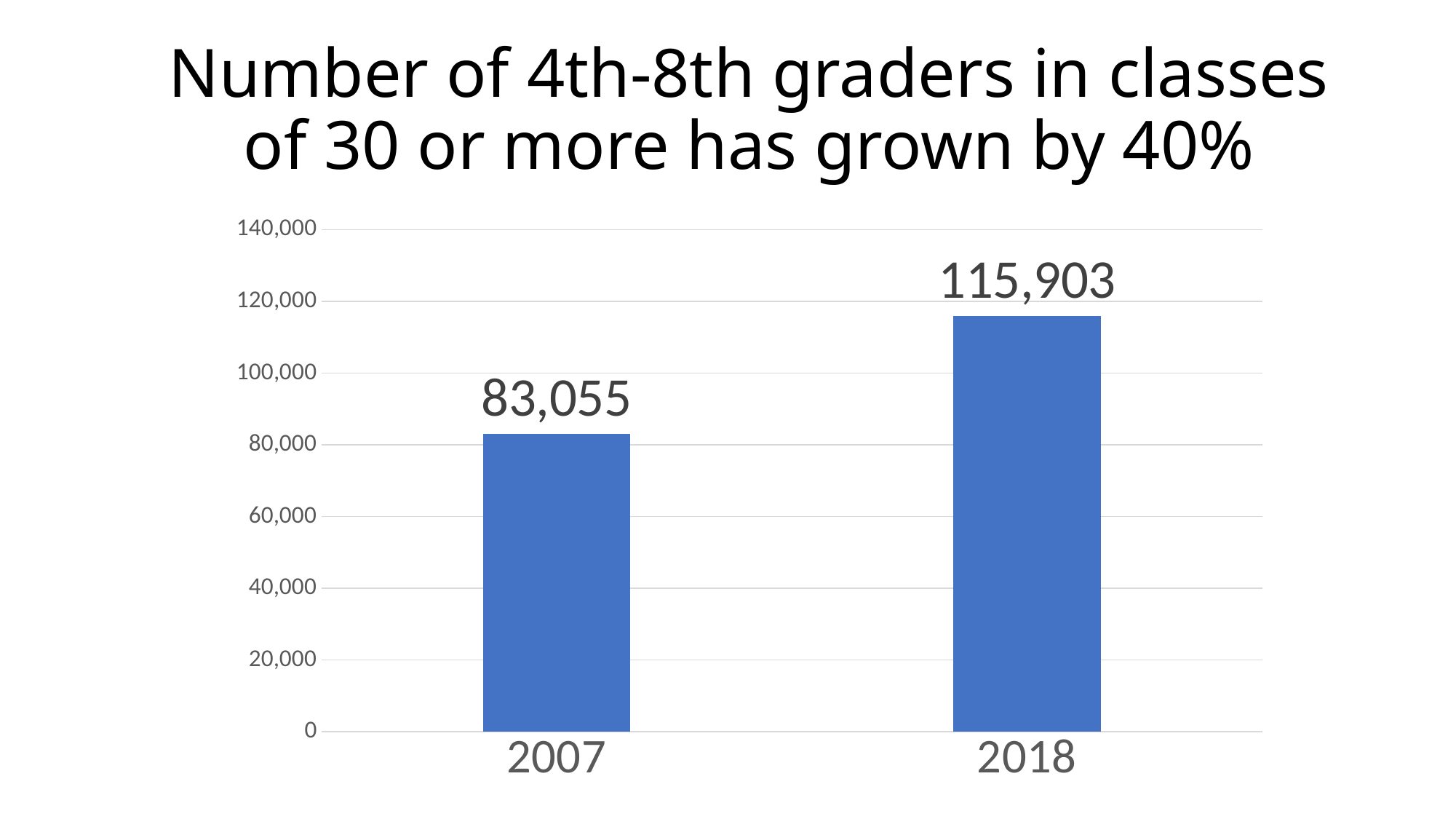
Do the values rise or fall from 2007 to 2018? Rise Is the value for 2018 greater or less than 100,000? greater Is the value for 2007 greater or less than 100,000? less What is the value for 2007? 83,055 What kind of chart is shown on the slide? Bar chart What is the value for 2018? 115,903 Which year has the higher value? 2018 Which year has the lower value? 2007 What is the title of the slide? Number of 4th-8th graders in classes of 30 or more has grown by 40% What is the difference between the values for 2018 and 2007? 32,848 Is the value for 2018 larger than the value for 2007? Yes How many years are shown on the chart? 2